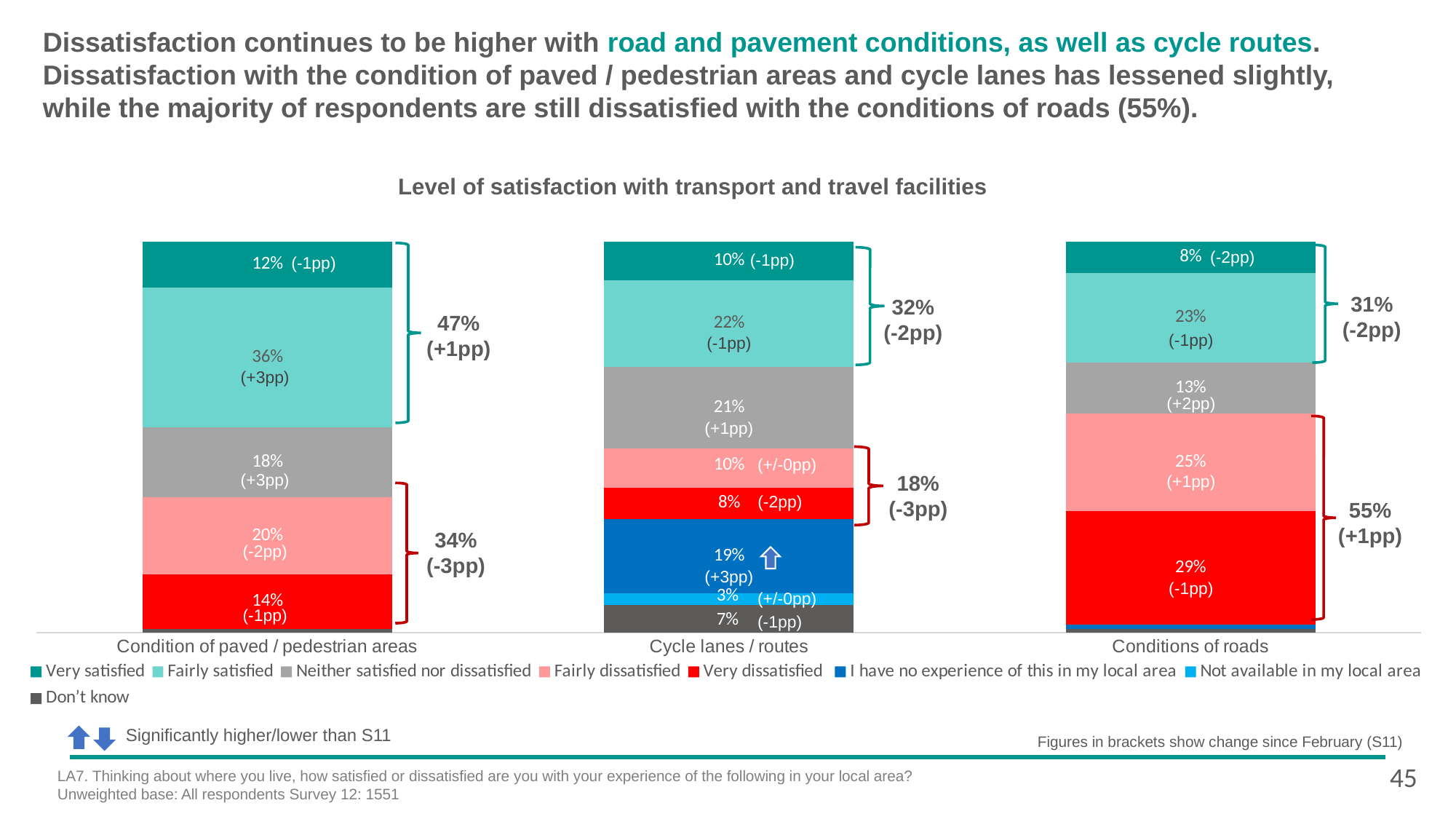
How many series does the legend list? 8 Which category has the lowest 'Very dissatisfied' value? Cycle lanes / routes What kind of chart is shown on the slide? Stacked bar chart What is the 'Very dissatisfied' value for Conditions of roads? 29% Which is larger: the 'Neither satisfied nor dissatisfied' value for Cycle lanes / routes or for Conditions of roads? Cycle lanes / routes How many categories are shown on the x axis? 3 What is the combined 'Fairly dissatisfied' and 'Very dissatisfied' total for Conditions of roads? 55% What is the chart's title? Level of satisfaction with transport and travel facilities What is the 'Fairly satisfied' value for Condition of paved / pedestrian areas? 36% What is the difference between the 'Fairly dissatisfied' values for Conditions of roads and Cycle lanes / routes? 15% What is the 'I have no experience of this in my local area' value for Cycle lanes / routes? 19% Which category has the highest 'Very satisfied' value? Condition of paved / pedestrian areas